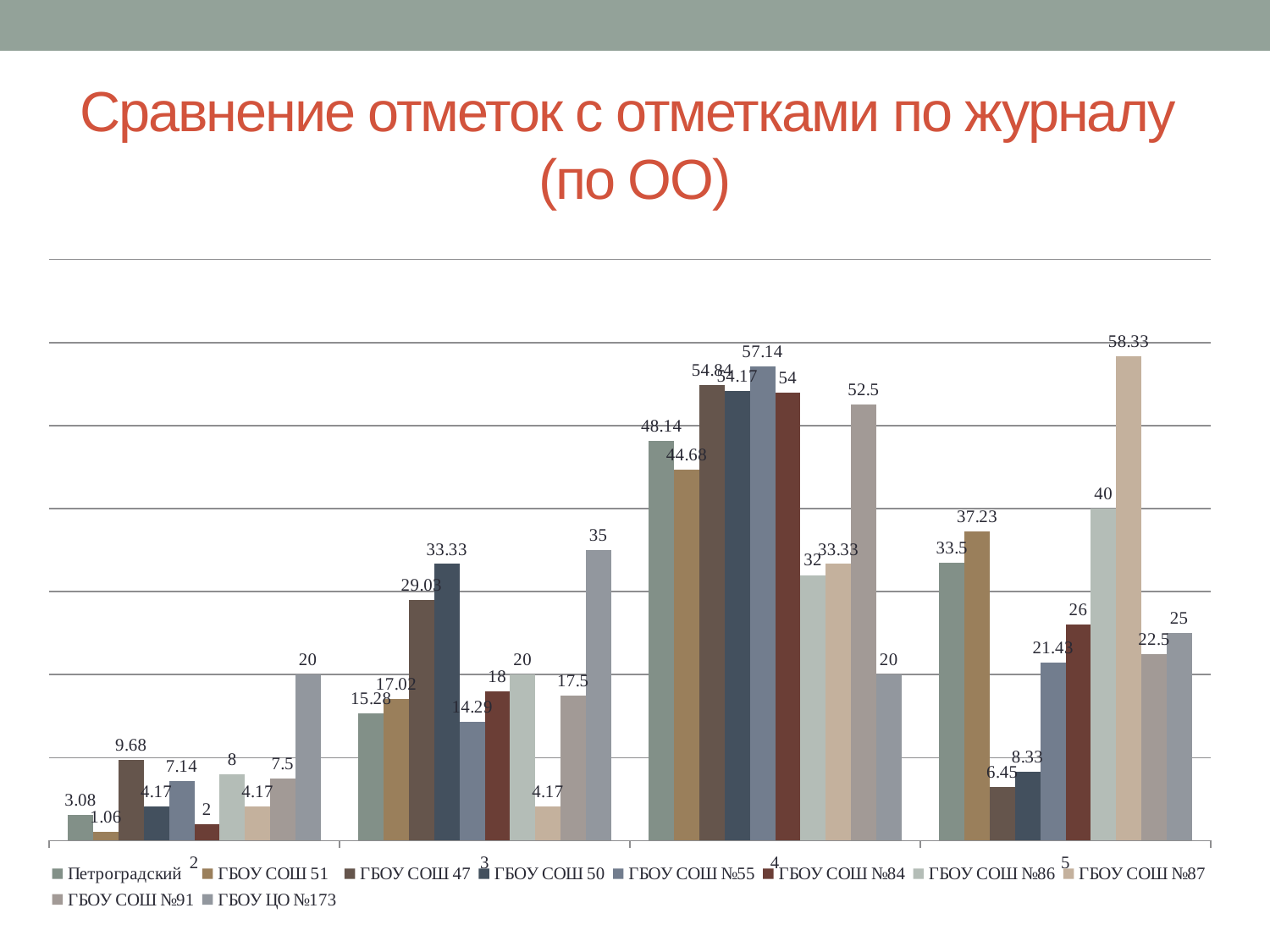
What is the value for ГБОУ ЦО №173 in category 3? 35 How many series does the legend list? 10 What is the value for ГБОУ СОШ 47 in category 5? 6.45 What is the title of the chart slide? Сравнение отметок с отметками по журналу (по ОО) Which series has the lowest value in category 2? ГБОУ СОШ 51 Which series has the highest value in category 5? ГБОУ СОШ №87 How many categories are shown along the x axis? 4 What kind of chart is shown on the slide? bar chart Which series has the highest value in category 4? ГБОУ СОШ №55 What is the value for Петроградский in category 4? 48.14 In category 5, what is the difference between the values for ГБОУ СОШ №87 and ГБОУ СОШ №86? 18.33 In category 4, which is larger: the value for ГБОУ СОШ №55 or for ГБОУ СОШ №84? ГБОУ СОШ №55